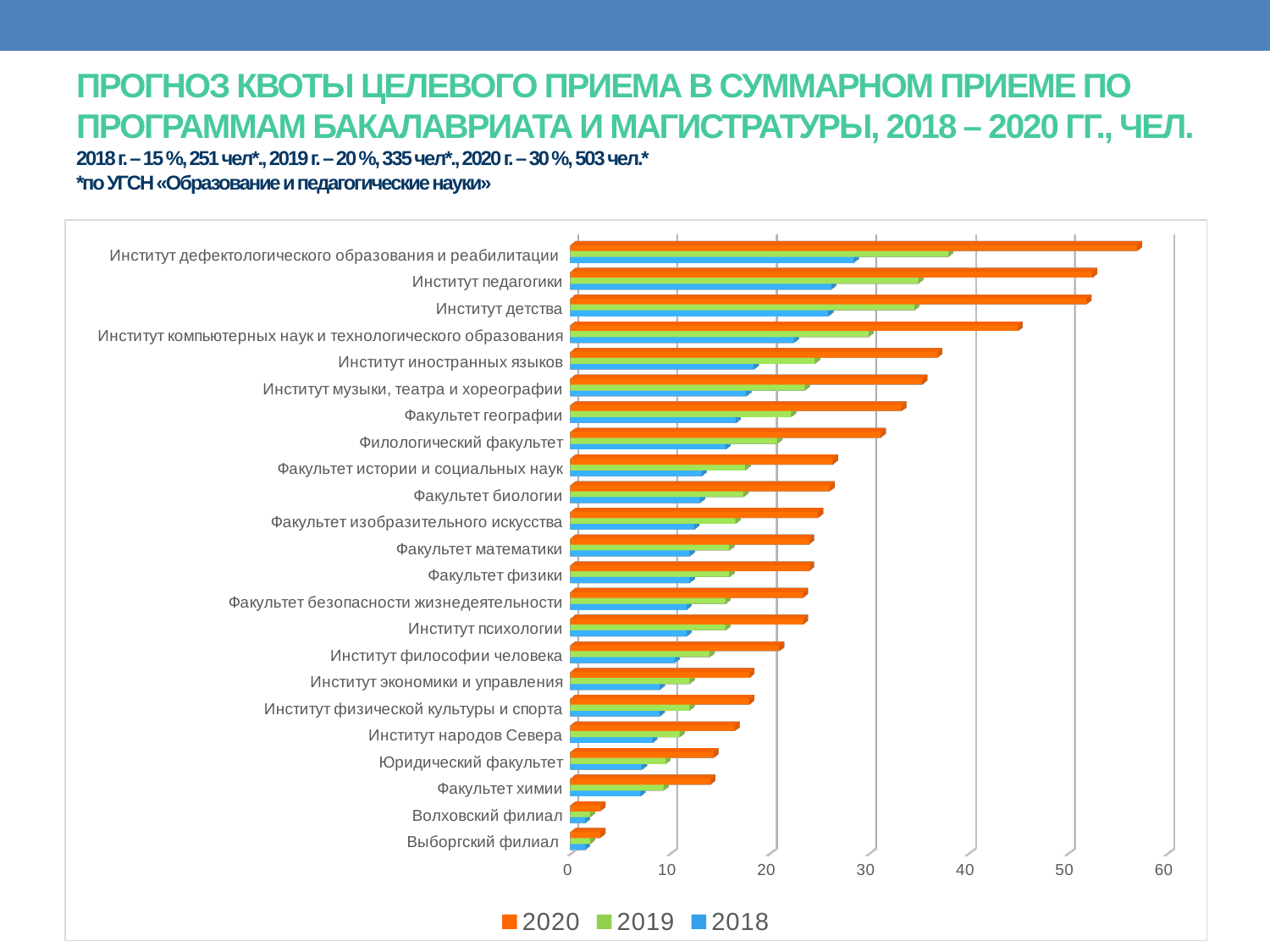
What kind of chart is shown on the slide? Bar chart Is the 2020 value for Институт дефектологического образования и реабилитации greater or less than 50? greater Which is larger: the 2020 value for Институт детства or the 2020 value for Институт иностранных языков? Институт детства Is the 2020 value for Институт иностранных языков greater or less than 40? less Is the 2020 value for Институт компьютерных наук и технологического образования greater or less than 50? less Which colour represents the 2018 series in the legend? Blue Which is larger: the 2020 value for Факультет географии or the 2020 value for Юридический факультет? Факультет географии How many institutes/faculties (categories) are plotted on the chart? 23 How many series does the legend list? 3 Which category has the highest value for 2020? Институт дефектологического образования и реабилитации